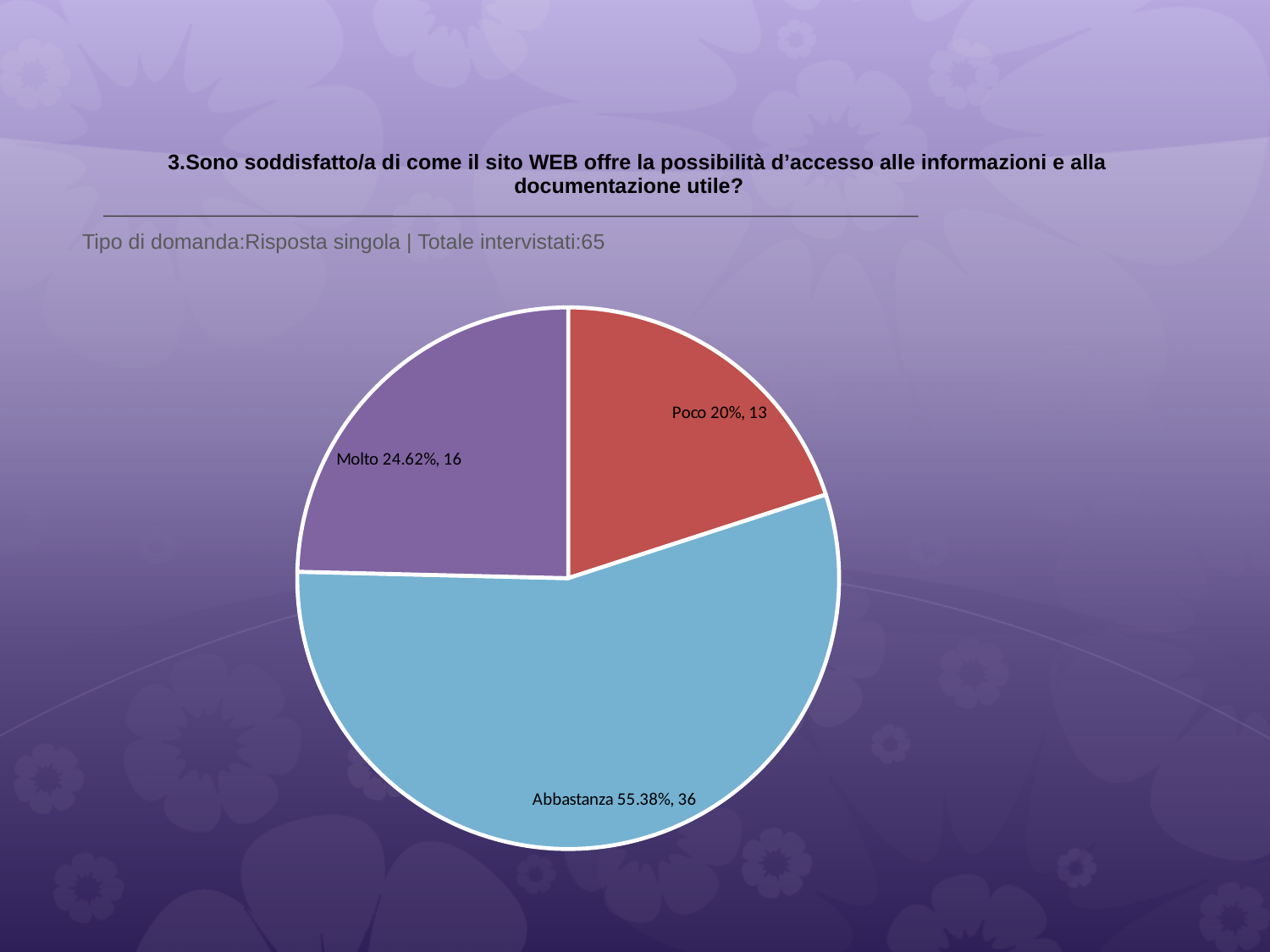
What percentage share does the Poco slice have? 20% How many more respondents answered Abbastanza than Molto? 20 What kind of chart is shown on the slide? pie chart How many respondents answered Abbastanza? 36 Which response has the largest slice of the pie? Abbastanza How many respondents answered Poco? 13 Which slice is larger, Molto or Poco? Molto How many respondents answered Molto? 16 How many slices does the pie chart have? 3 What percentage share does the Molto slice have? 24.62% Which response has the smallest slice of the pie? Poco What percentage share does the Abbastanza slice have? 55.38%